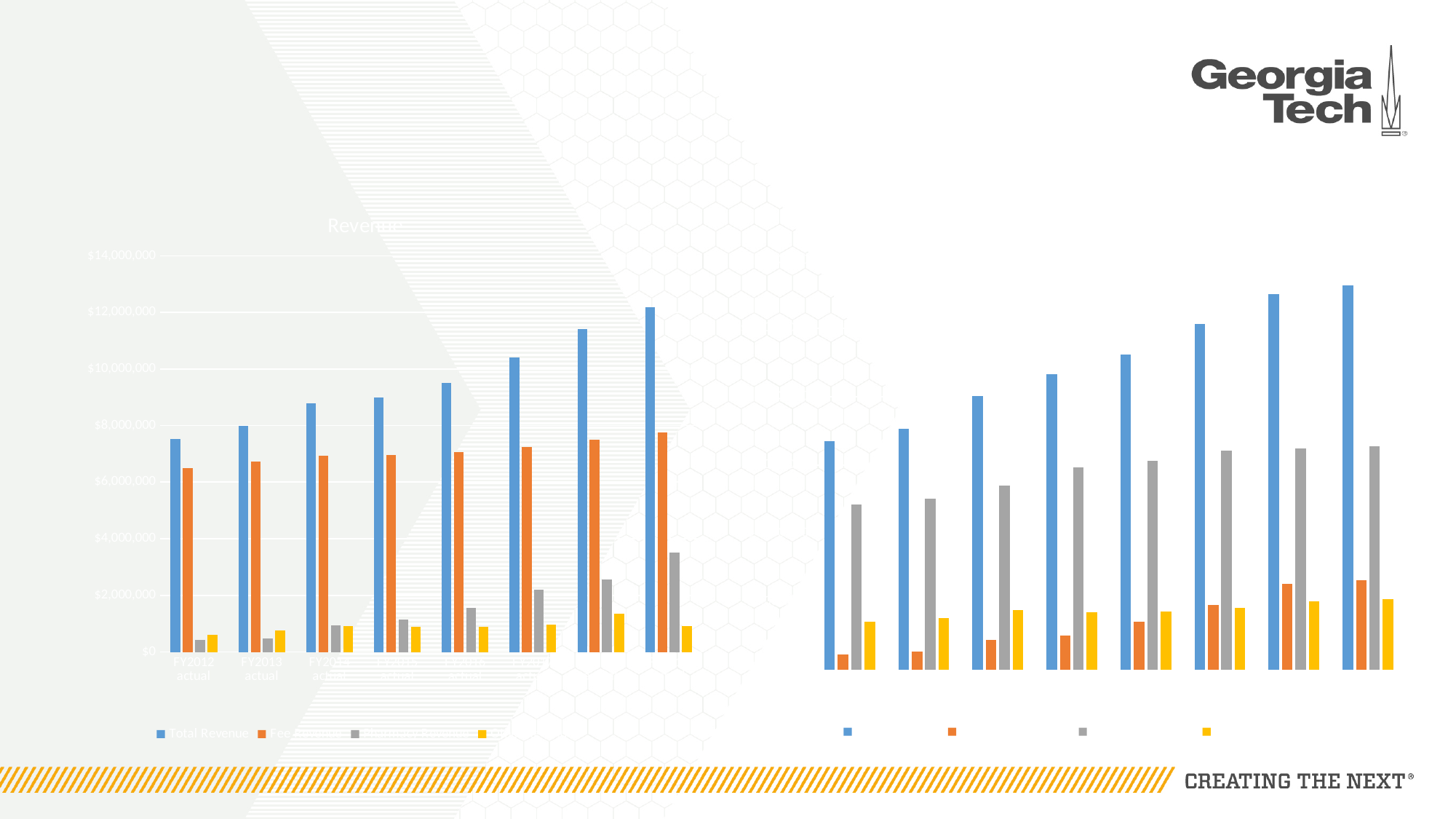
In the left chart titled "Revenue", do the Total Revenue bars rise or fall from left to right across the fiscal years? rise In the left chart titled "Revenue", which series has the tallest bar in every category group? Total Revenue What is the title of the left chart? Revenue In the left chart titled "Revenue", how many series does the legend list? 4 In the left chart titled "Revenue", how many category groups of bars are plotted? 8 In the left chart titled "Revenue", which is larger for FY2012 actual: Total Revenue or Fee Revenue? Total Revenue In the left chart titled "Revenue", is the Fee Revenue value for FY2012 actual greater or less than $4,000,000? greater What kind of chart is the left chart titled "Revenue"? bar chart In the chart on the right side of the slide, do the blue bars rise or fall from left to right? rise What kind of chart is the chart on the right side of the slide? bar chart In the left chart titled "Revenue", is the Total Revenue value for FY2013 actual greater or less than $6,000,000? greater In the left chart titled "Revenue", is the Total Revenue value for FY2012 actual greater or less than $8,000,000? less